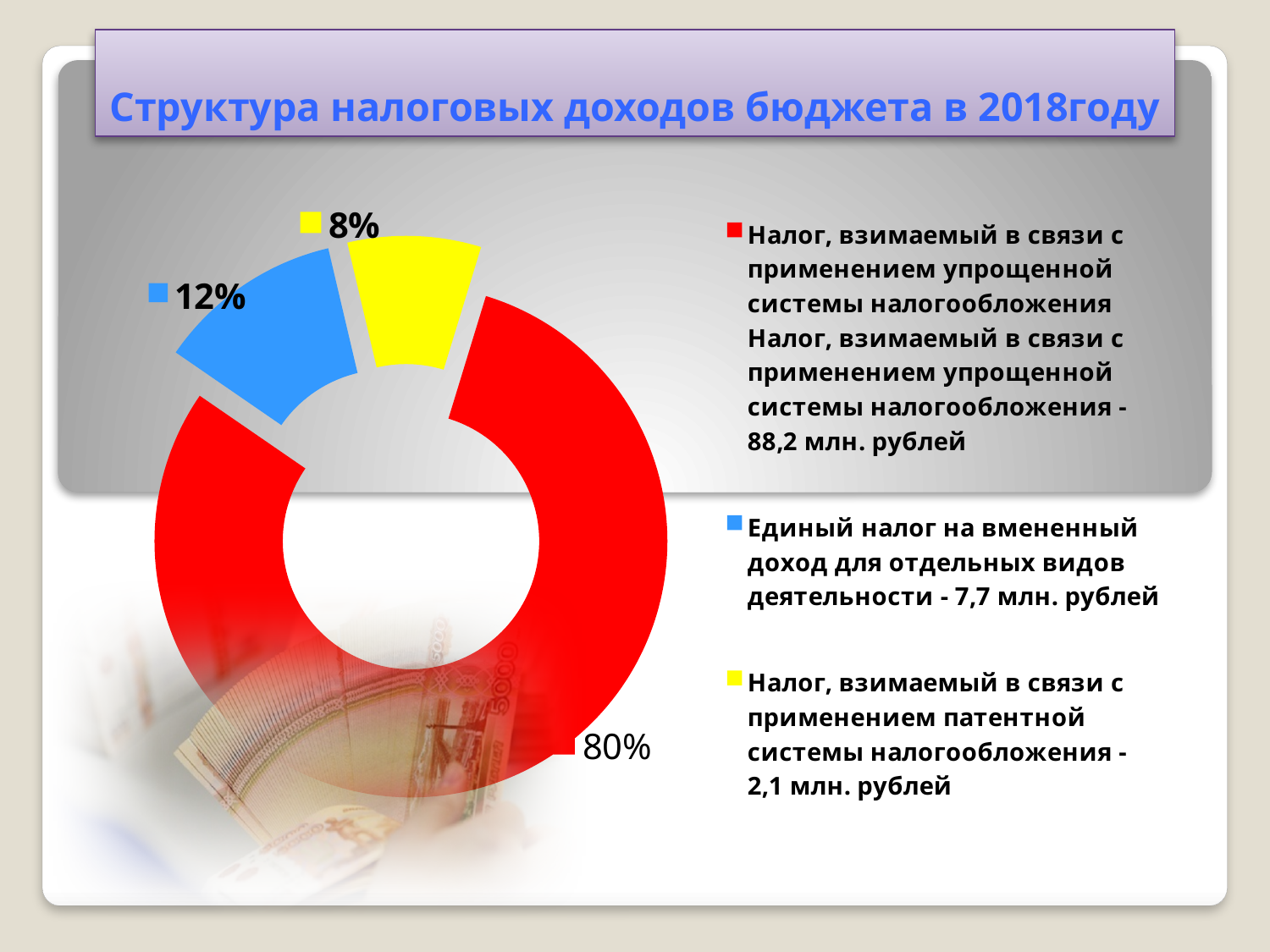
According to the legend, what amount in million rubles corresponds to Единый налог на вмененный доход для отдельных видов деятельности? 7,7 млн. рублей What share of the chart does the red slice (Налог, взимаемый в связи с применением упрощенной системы налогообложения) represent? 80% Which is larger: the share of Единый налог на вмененный доход or the share of the патентной системы налогообложения? Единый налог на вмененный доход Which category has the smallest share of the chart? Налог, взимаемый в связи с применением патентной системы налогообложения What share of the chart does the blue slice (Единый налог на вмененный доход для отдельных видов деятельности) represent? 12% What is the title of the slide containing the chart? Структура налоговых доходов бюджета в 2018году Which category has the largest share of the chart? Налог, взимаемый в связи с применением упрощенной системы налогообложения What is the difference in percentage points between the blue slice (12%) and the yellow slice (8%)? 4 percentage points How many slices does the chart have? 3 What share of the chart does the yellow slice (Налог, взимаемый в связи с применением патентной системы налогообложения) represent? 8% What kind of chart is shown on the slide? Doughnut (pie) chart What is the difference in percentage points between the red slice (80%) and the blue slice (12%)? 68 percentage points